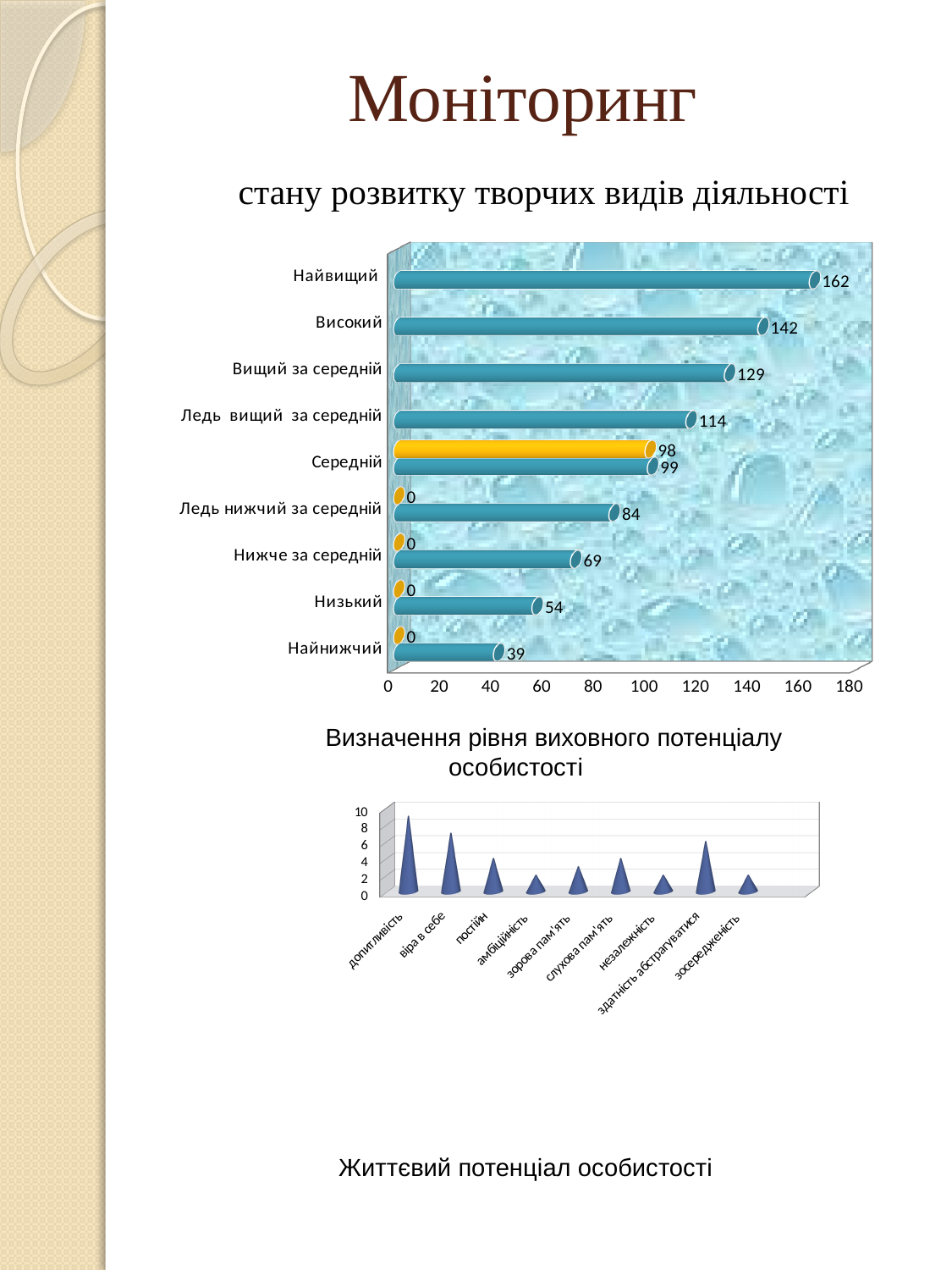
In the top bar chart, which is larger: the value for Низький or the value for Нижче за середній? Нижче за середній In the top bar chart, what is the value for Найвищий? 162 In the top bar chart, what is the value for Найнижчий? 39 In the top bar chart, what is the difference between the values for Високий and Вищий за середній? 13 In the bottom chart titled 'Визначення рівня виховного потенціалу особистості', which category has the highest value? допитливість In the top bar chart, what is the value of the blue bar for Середній? 99 In the top bar chart, what is the value of the yellow bar for Середній? 98 In the bottom chart titled 'Визначення рівня виховного потенціалу особистості', how many categories are shown on the x axis? 9 In the bottom chart titled 'Визначення рівня виховного потенціалу особистості', is the value for допитливість greater or less than 6? greater In the top bar chart, which category has the highest value? Найвищий What type of chart is the top chart on the slide? Bar chart In the top bar chart, how many categories are shown on the vertical axis? 9